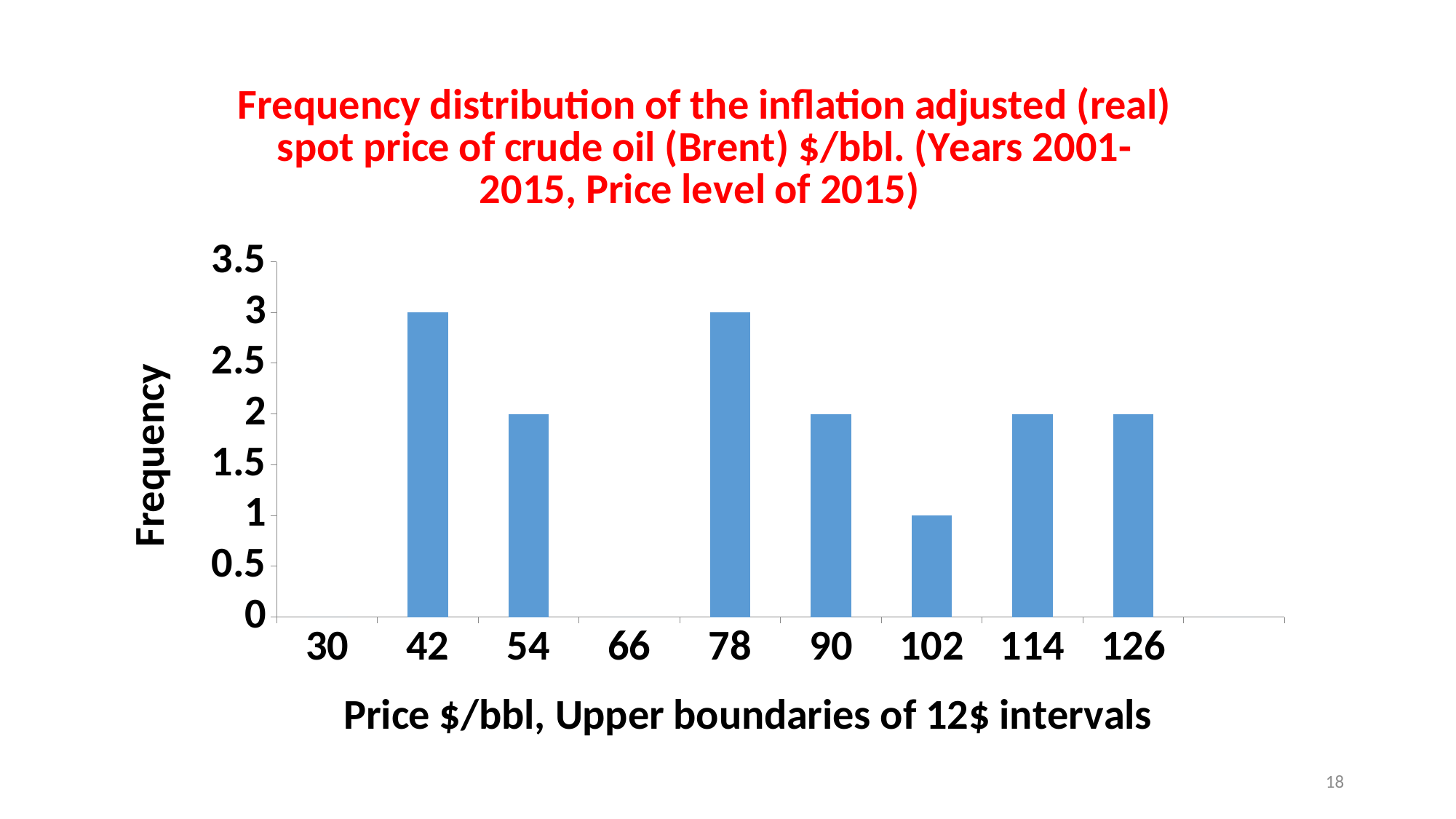
What is the frequency for the price category 66? 0 What is the difference between the frequency for 78 and the frequency for 102? 2 What is the title of the vertical axis? Frequency Is the frequency for the price category 90 greater or less than 2.5? less What is the frequency for the price category 42? 3 Which has the larger frequency, the price category 54 or 102? 54 What is the frequency for the price category 102? 1 Is the frequency for the price category 78 greater or less than 2.5? greater Which price category has a frequency of 1? 102 What is the frequency for the price category 114? 2 What kind of chart is shown on the slide? bar chart How many price categories are shown on the x axis? 9